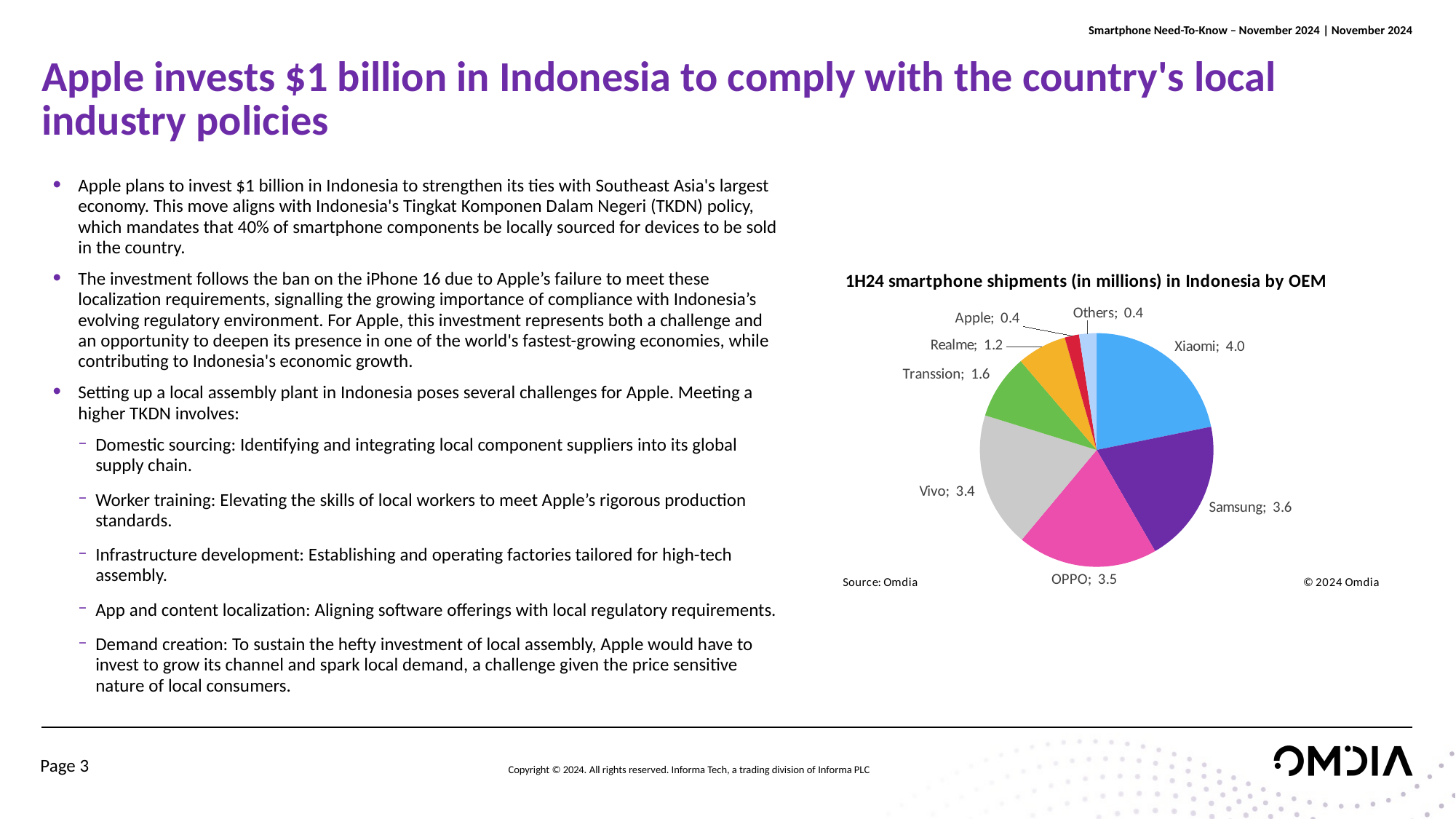
How many OEM categories are shown in the pie chart? 8 What is the value for Xiaomi in the pie chart? 4.0 What kind of chart is shown on the slide? Pie chart What is the difference between the values for Vivo and Transsion? 1.8 What is the total of all the values shown in the pie chart? 18.1 What is the value for Apple in the pie chart? 0.4 What is the difference between the values for Xiaomi and Samsung? 0.4 What is the value for Transsion in the pie chart? 1.6 What is the title of the chart? 1H24 smartphone shipments (in millions) in Indonesia by OEM Which OEM has the largest slice in the pie chart? Xiaomi Which is larger, the value for Samsung or the value for OPPO? Samsung What is the value for Realme in the pie chart? 1.2